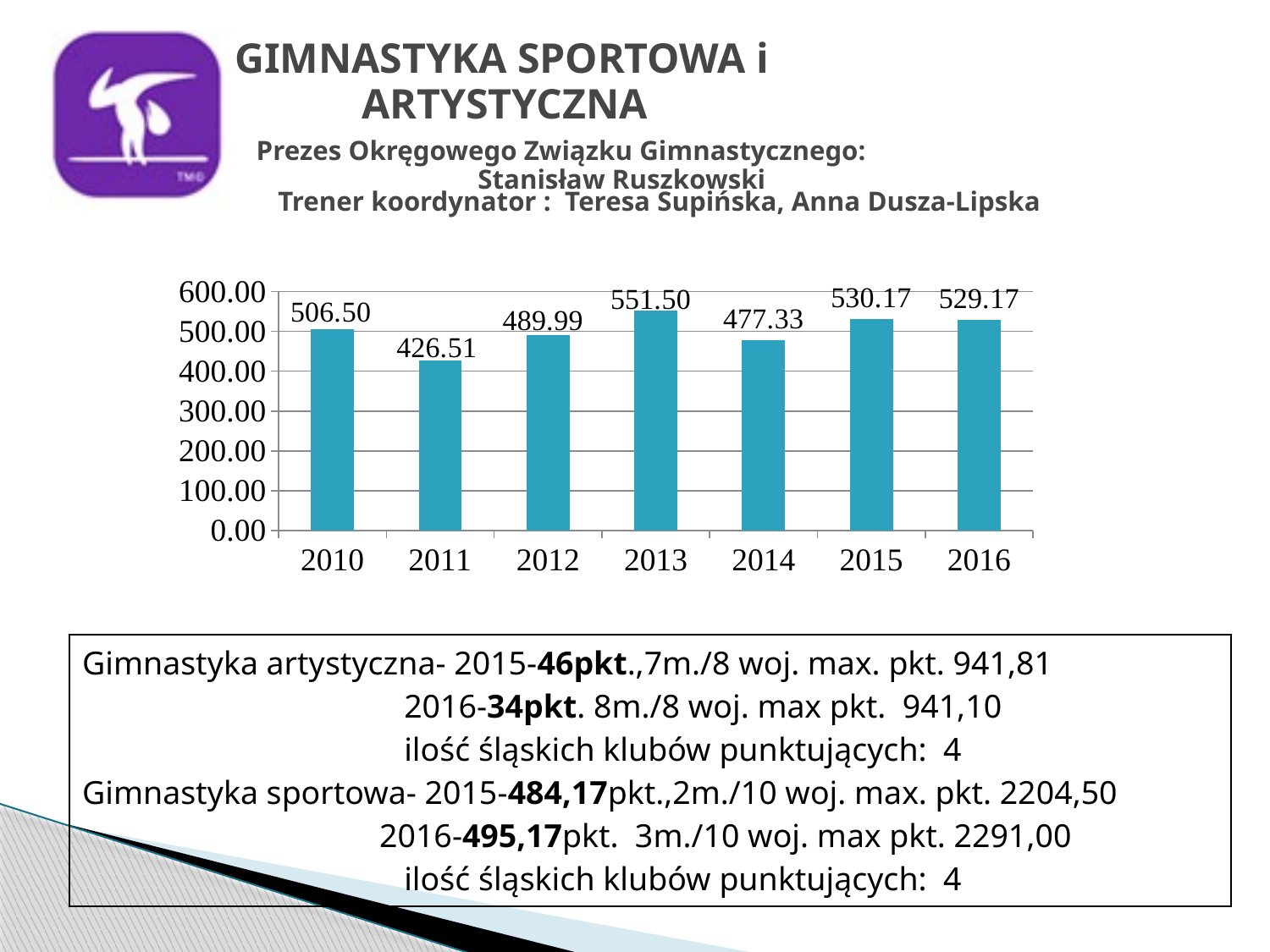
What kind of chart is shown on the slide? bar chart How many years are shown on the x axis of the chart? 7 What is the difference between the values for 2013 and 2011? 124.99 What is the value shown for 2016? 529.17 Which year has the highest value in the chart? 2013 What is the value shown for 2011? 426.51 What is the value shown for 2013? 551.50 Which is larger, the value for 2010 or the value for 2014? 2010 What is the difference between the values for 2010 and 2014? 29.17 Is the value for 2011 greater or less than 500.00? less Between 2011 and 2013, do the values rise or fall? rise Which year has the lowest value in the chart? 2011